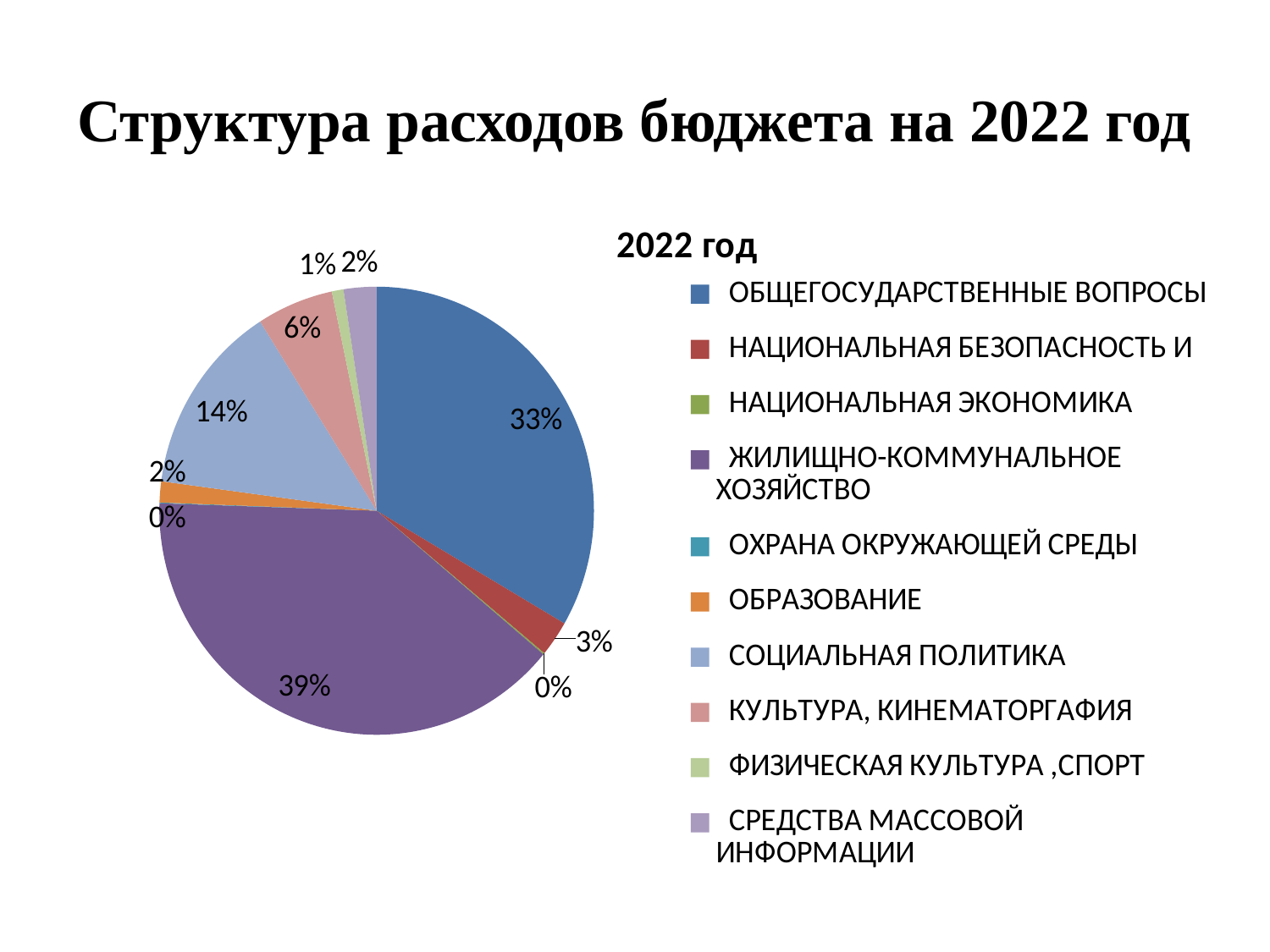
What share of the pie is ЖИЛИЩНО-КОММУНАЛЬНОЕ ХОЗЯЙСТВО? 39% Which is larger, the share for ОБЩЕГОСУДАРСТВЕННЫЕ ВОПРОСЫ or the share for СОЦИАЛЬНАЯ ПОЛИТИКА? ОБЩЕГОСУДАРСТВЕННЫЕ ВОПРОСЫ How many categories does the legend list? 10 What is the difference between the share for ЖИЛИЩНО-КОММУНАЛЬНОЕ ХОЗЯЙСТВО and the share for ОБЩЕГОСУДАРСТВЕННЫЕ ВОПРОСЫ? 6% What share of the pie is КУЛЬТУРА, КИНЕМАТОРГАФИЯ? 6% What share of the pie is СОЦИАЛЬНАЯ ПОЛИТИКА? 14% What is the title of the chart? 2022 год Which category has the largest slice of the pie? ЖИЛИЩНО-КОММУНАЛЬНОЕ ХОЗЯЙСТВО What kind of chart is shown on the slide? pie chart What colour is the slice for ОБРАЗОВАНИЕ? orange